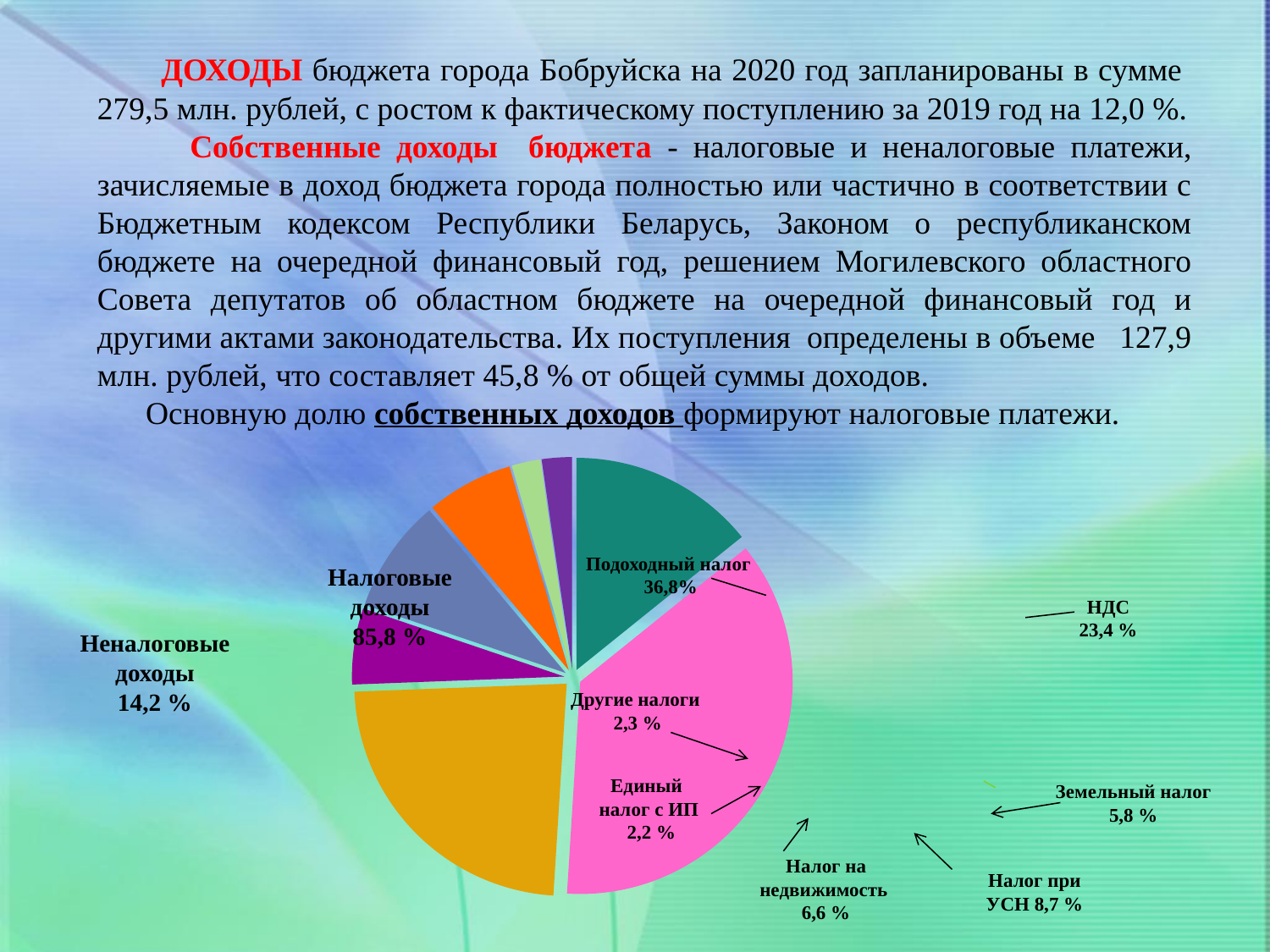
What share is labelled for Налоговые доходы on the chart? 85,8 % What share is labelled for Земельный налог in the pie chart? 5,8 % What share is labelled for Налог при УСН in the pie chart? 8,7 % Which labelled tax has the largest share in the pie chart? Подоходный налог By how many percentage points does the share of Подоходный налог exceed the share of НДС? 13,4 % What share is labelled for Налог на недвижимость in the pie chart? 6,6 % What share is labelled for Единый налог с ИП in the pie chart? 2,2 % What share is labelled for Подоходный налог in the pie chart? 36,8 % What kind of chart is shown on the slide? pie chart What share is labelled for Неналоговые доходы on the chart? 14,2 % What share is labelled for НДС in the pie chart? 23,4 % Which is larger in the pie chart, НДС or Налог при УСН? НДС